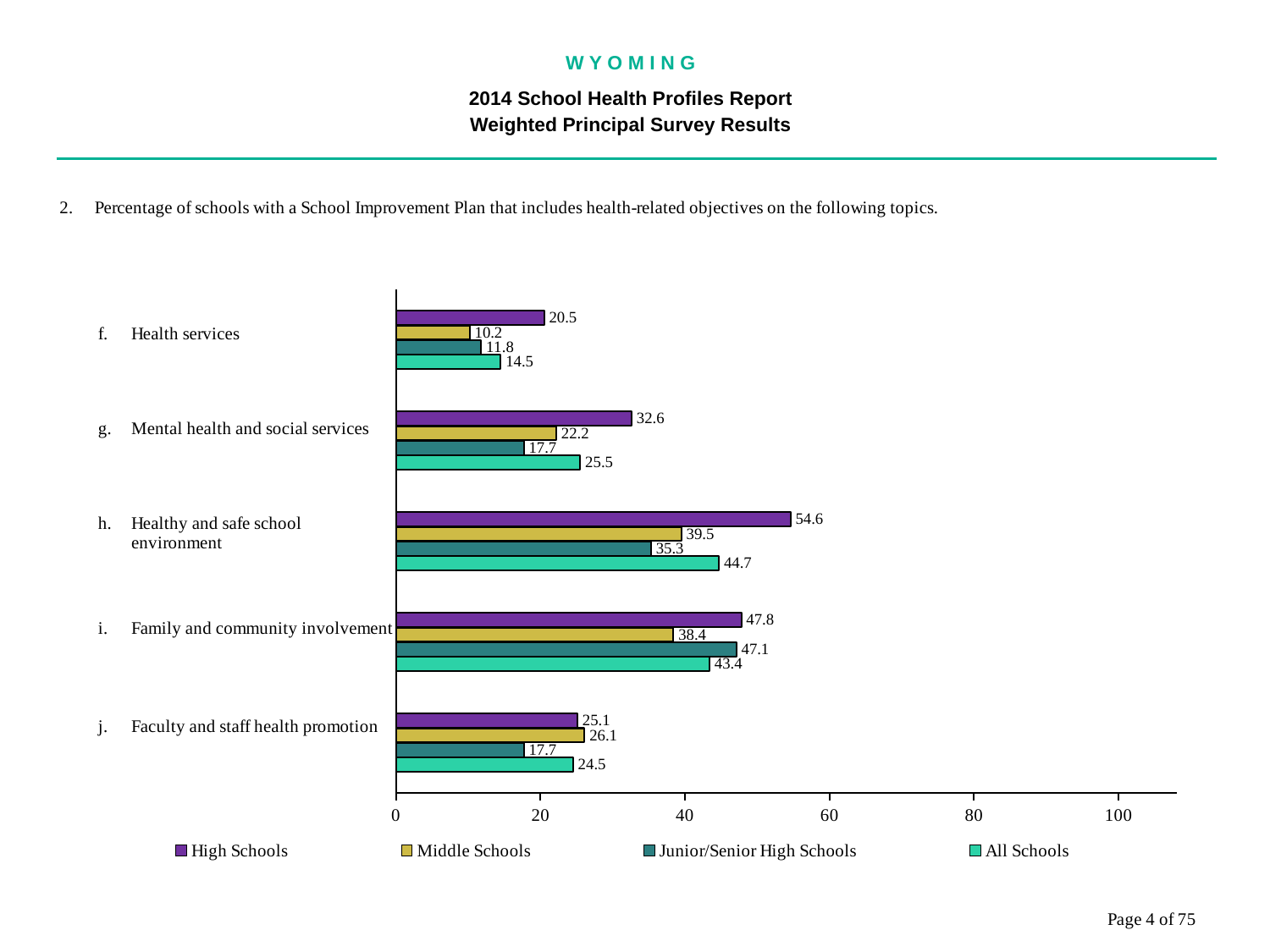
What is the difference between the High Schools and Middle Schools values for Mental health and social services? 10.4 How many topics (categories) are shown on the chart? 5 How many series does the legend list? 4 Which topic has the highest value for High Schools? Healthy and safe school environment What is the value for High Schools for Healthy and safe school environment? 54.6 What kind of chart is shown on the slide? Bar chart What is the value for Junior/Senior High Schools for Faculty and staff health promotion? 17.7 What is the value for All Schools for Family and community involvement? 43.4 For Faculty and staff health promotion, which is larger: the High Schools value or the Middle Schools value? Middle Schools Which topic has the lowest value for All Schools? Health services What is the value for Middle Schools for Health services? 10.2 Is the value for High Schools for Family and community involvement greater or less than 40? greater